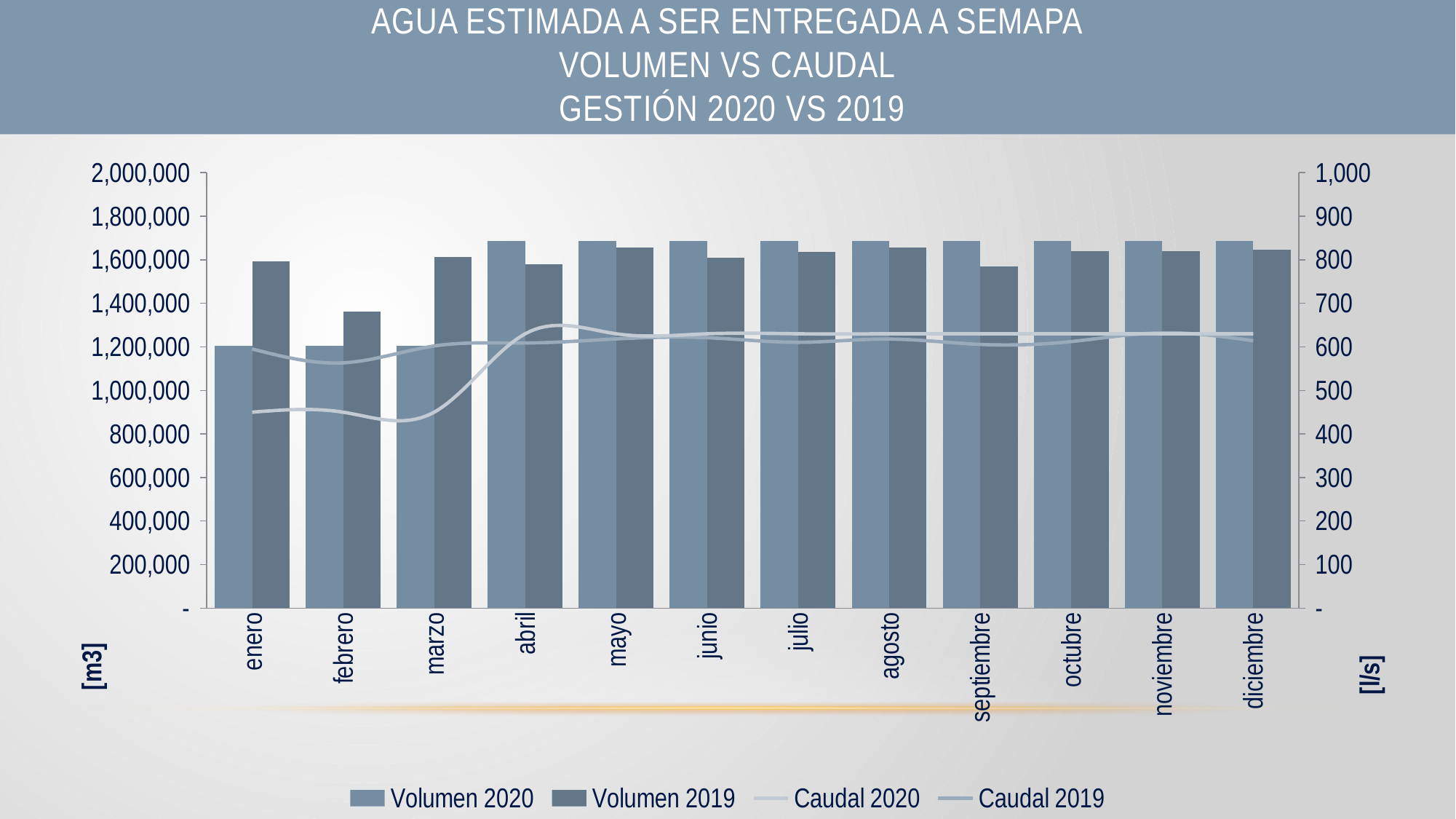
Is the Volumen 2019 value for febrero greater or less than 1,400,000? less Is the Volumen 2020 value for enero greater or less than 1,400,000? less Is the Caudal 2020 value for enero greater or less than 500? less How many months are shown along the x axis? 12 In enero, which is larger: Volumen 2020 or Volumen 2019? Volumen 2019 Which month has the lowest Volumen 2019 bar? febrero Does the Caudal 2020 line rise or fall from marzo to abril? rise How many series does the legend list? 4 In abril, which is larger: Volumen 2020 or Volumen 2019? Volumen 2020 What unit label is shown on the right-hand axis? [l/s] What kind of chart is shown on the slide? A combined bar and line chart